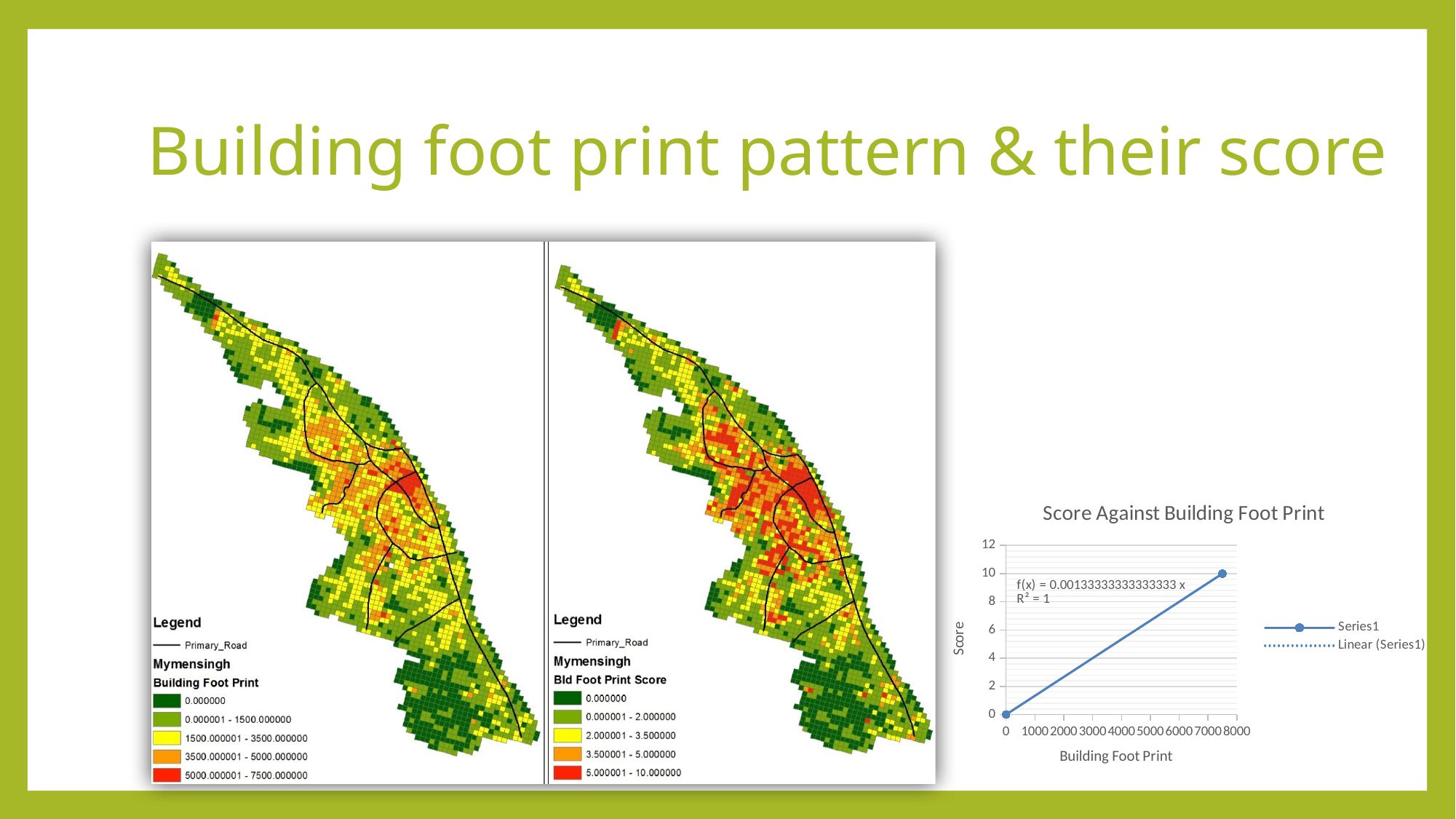
In the chart 'Score Against Building Foot Print', what kind of chart is it? line chart In the chart 'Score Against Building Foot Print', what R² value is shown for the trendline? R² = 1 In the chart 'Score Against Building Foot Print', is the building foot print value of the highest point greater or less than 8000? less What is the title of the chart on the right side of the slide? Score Against Building Foot Print In the chart 'Score Against Building Foot Print', what are the titles of the x axis and y axis? Building Foot Print (x axis), Score (y axis) In the chart 'Score Against Building Foot Print', how many entries does the legend list? 2 In the chart 'Score Against Building Foot Print', how many data points are plotted? 2 In the chart 'Score Against Building Foot Print', what is the highest score value plotted? 10 In the chart 'Score Against Building Foot Print', is the building foot print value of the highest point greater or less than 7000? greater In the chart 'Score Against Building Foot Print', does the score rise or fall as building foot print increases? rises In the chart 'Score Against Building Foot Print', what equation is shown for the trendline? f(x) = 0.00133333333333333 x In the chart 'Score Against Building Foot Print', what is the lowest score value plotted? 0